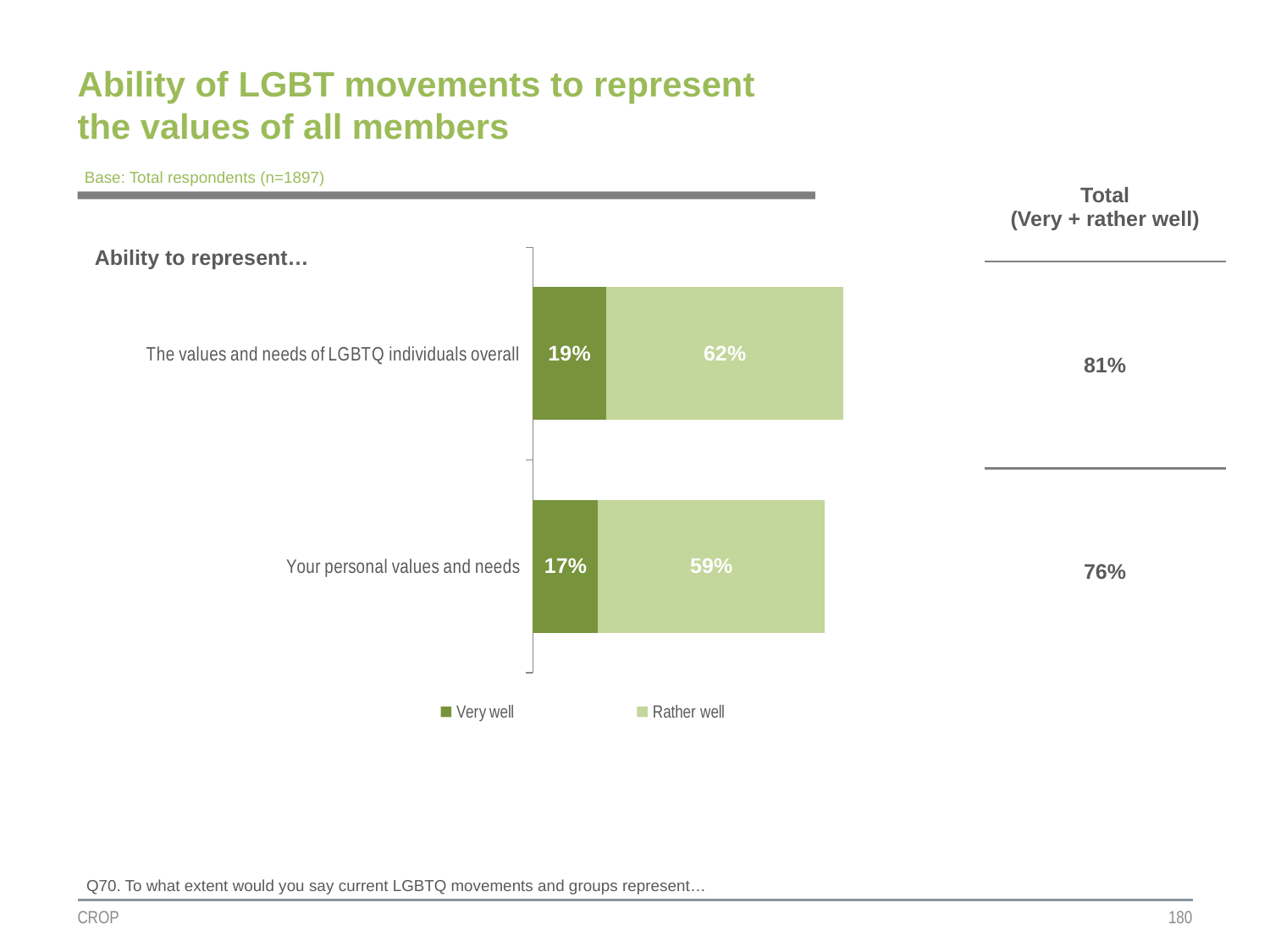
What is the total (Very + rather well) for 'The values and needs of LGBTQ individuals overall'? 81% What is the total (Very + rather well) for 'Your personal values and needs'? 76% What percentage of respondents said LGBTQ movements represent the values and needs of LGBTQ individuals overall 'Rather well'? 62% What percentage of respondents said LGBTQ movements represent their personal values and needs 'Rather well'? 59% Which category has the lower 'Very well' percentage? Your personal values and needs What percentage of respondents said LGBTQ movements represent the values and needs of LGBTQ individuals overall 'Very well'? 19% What is the difference between the 'Rather well' percentages for the two categories? 3 percentage points How many series does the legend list? 2 What percentage of respondents said LGBTQ movements represent their personal values and needs 'Very well'? 17% Which category has the higher 'Rather well' percentage? The values and needs of LGBTQ individuals overall What kind of chart is shown on the slide? Stacked bar chart What is the difference between the totals (Very + rather well) for the two categories? 5 percentage points